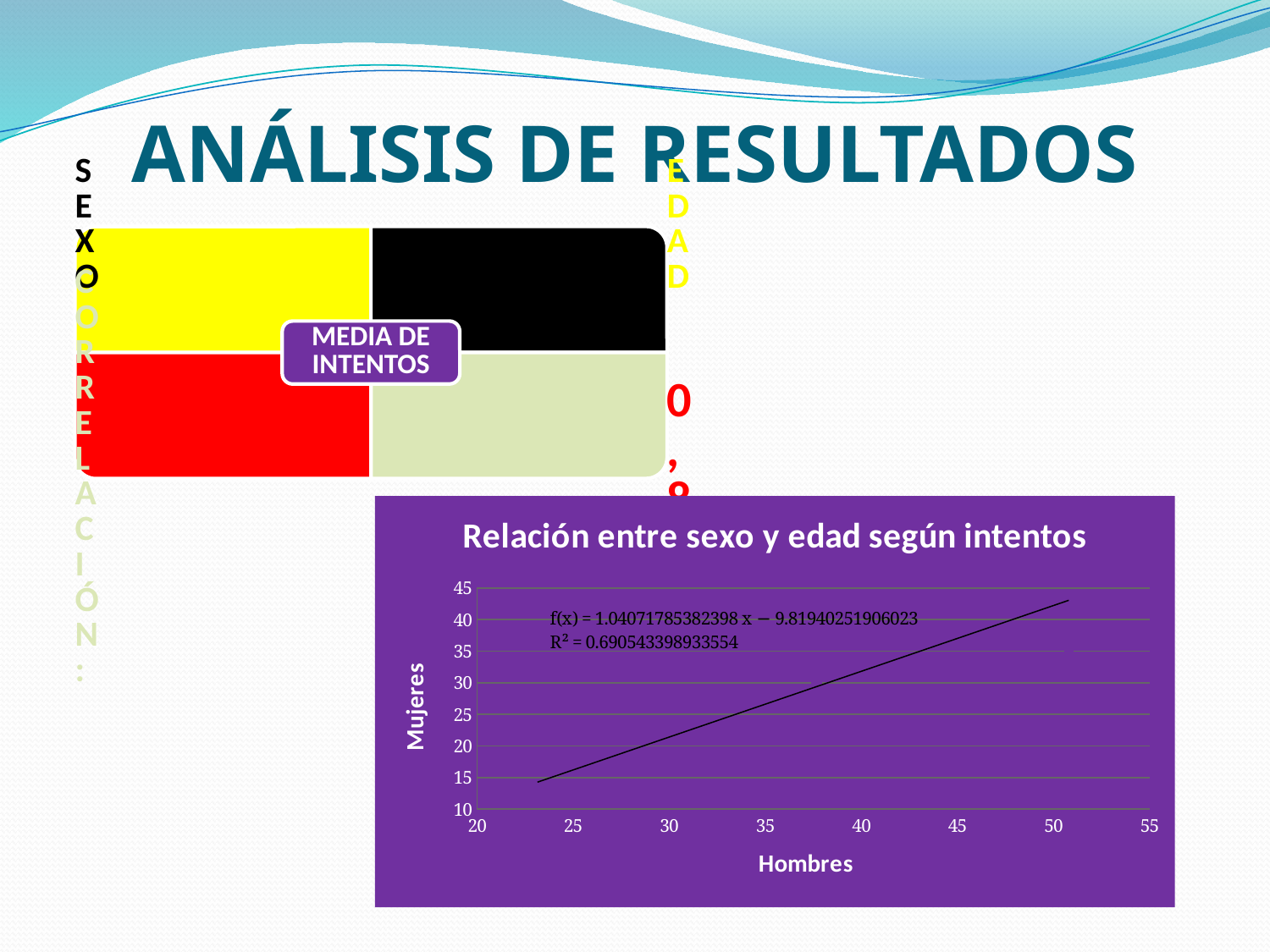
Is the R² value printed on the chart greater or less than 0.5? greater What is the trendline equation printed on the chart? f(x) = 1.04071785382398 x − 9.81940251906023 What R² value is printed on the chart? R² = 0.690543398933554 What is the title of the chart on the slide? Relación entre sexo y edad según intentos What is the label of the horizontal axis of the chart? Hombres Does the trendline in the chart rise or fall as the x-axis values increase? rise What is the lowest tick value shown on the horizontal axis of the chart? 20 Is the slope of the trendline equation printed on the chart greater or less than 1? greater What is the highest tick value shown on the vertical axis of the chart? 45 What is the highest tick value shown on the horizontal axis of the chart? 55